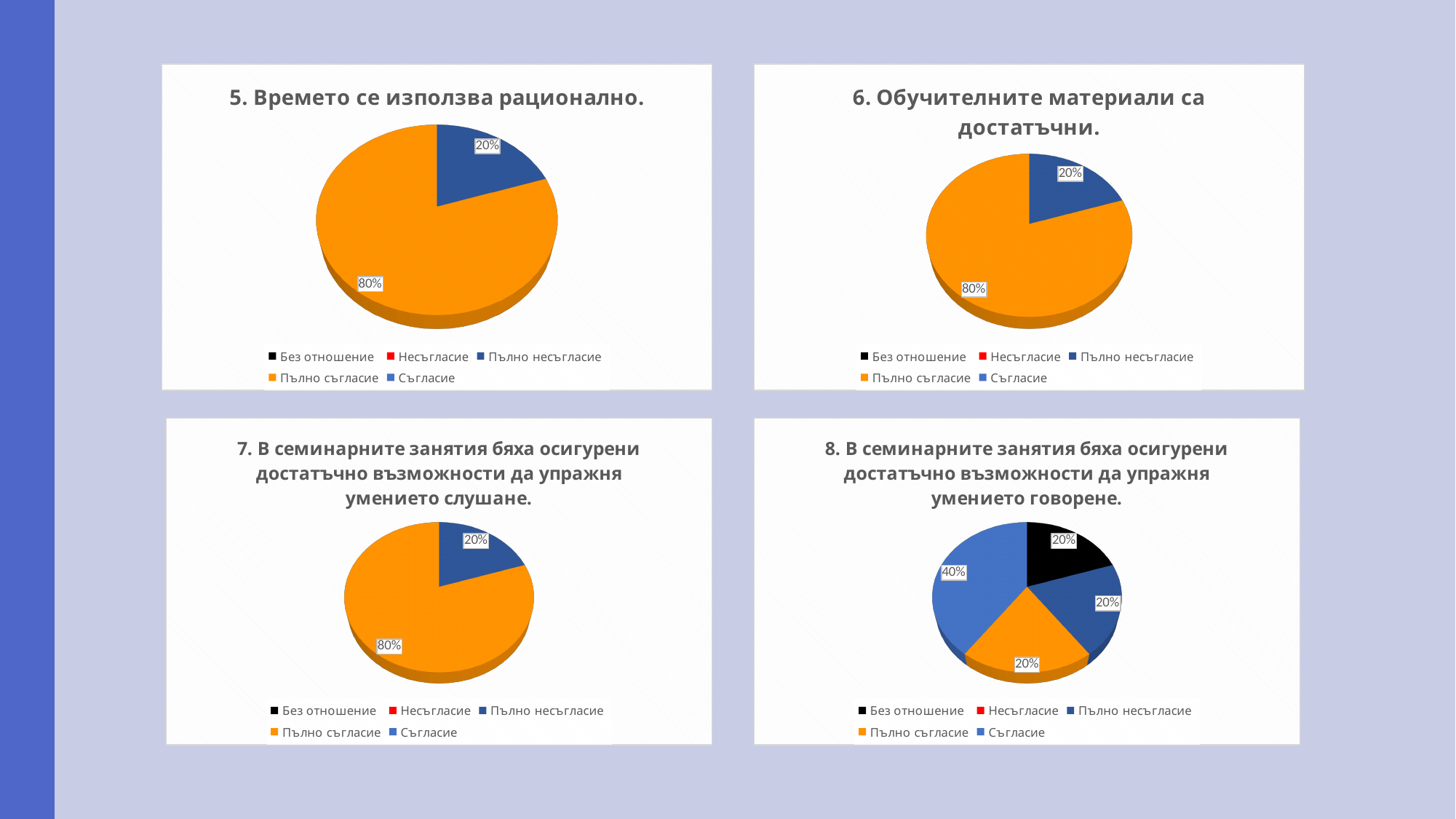
In the chart titled "5. Времето се използва рационално.", what share of the pie is "Пълно съгласие"? 80% In the bottom-right chart (question 8), what is the value for "Без отношение"? 20% In the chart titled "5. Времето се използва рационално.", what is the value for "Пълно несъгласие"? 20% What type of chart is used for "6. Обучителните материали са достатъчни."? Pie chart In the bottom-left chart (question 7), what is the value for "Пълно несъгласие"? 20% In the chart titled "6. Обучителните материали са достатъчни.", what is the difference between the "Пълно съгласие" and "Пълно несъгласие" slices? 60% In the bottom-left chart (question 7), which is larger: "Пълно съгласие" or "Пълно несъгласие"? Пълно съгласие How many slices are shown in the bottom-right chart (question 8)? 4 In the bottom-right chart (question 8), what share of the pie is "Съгласие"? 40% In the bottom-right chart (question 8), which category has the largest slice? Съгласие How many entries does the legend list in the chart titled "5. Времето се използва рационално."? 5 In the chart titled "6. Обучителните материали са достатъчни.", which category has the largest slice? Пълно съгласие